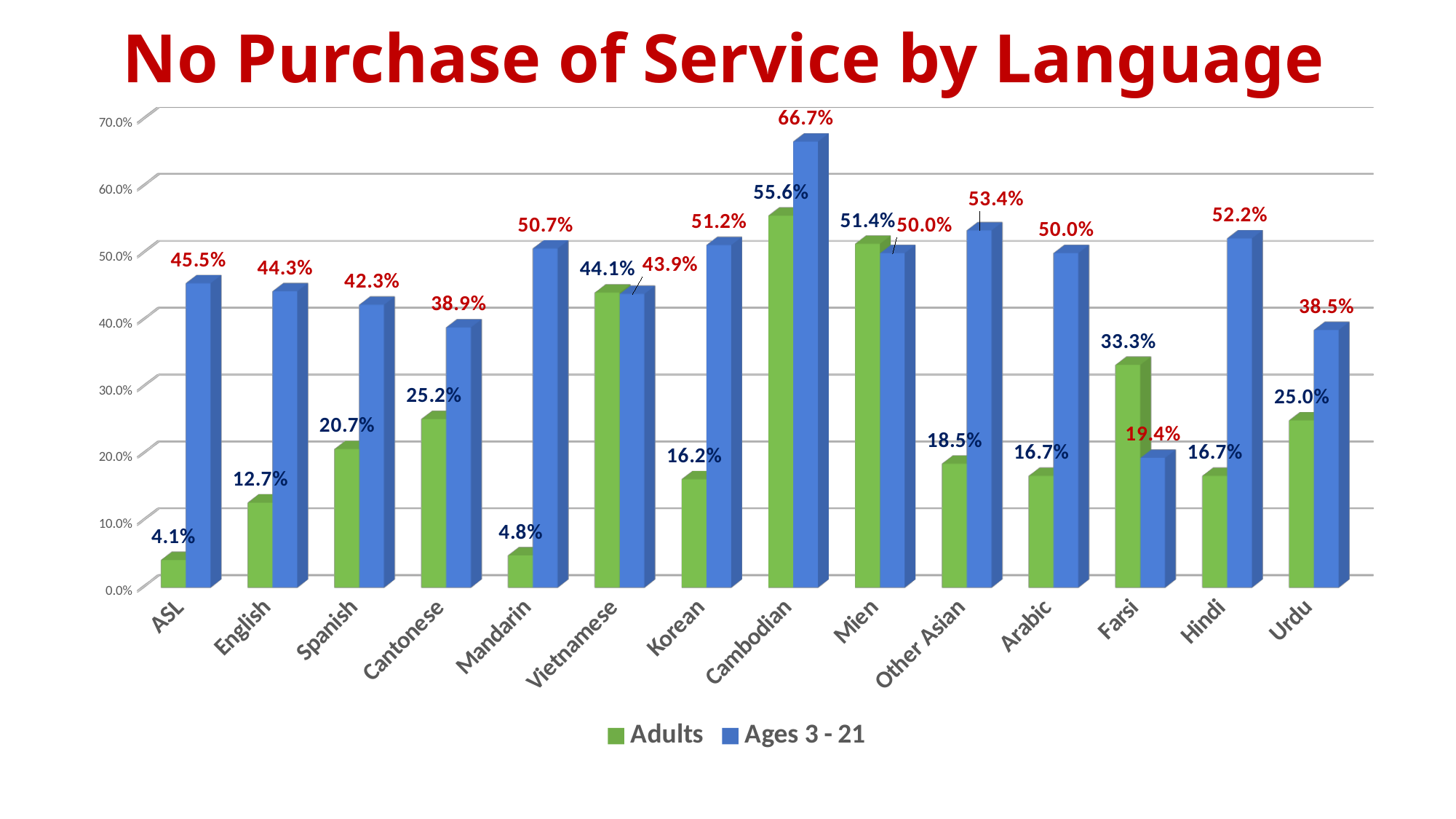
What is the title of the chart? No Purchase of Service by Language How many languages are shown on the x axis? 14 Which language has the lowest Ages 3 - 21 value? Farsi What is the Adults value for Mandarin? 4.8% What is the difference between the Ages 3 - 21 and Adults values for Cambodian? 11.1 percentage points What kind of chart is shown on the slide? Bar chart For Farsi, which series has the larger value, Adults or Ages 3 - 21? Adults What is the Ages 3 - 21 value for Hindi? 52.2% What is the Adults value for Cantonese? 25.2% Which language has the lowest Adults value? ASL How many series does the legend list? 2 Which language has the highest Ages 3 - 21 value? Cambodian